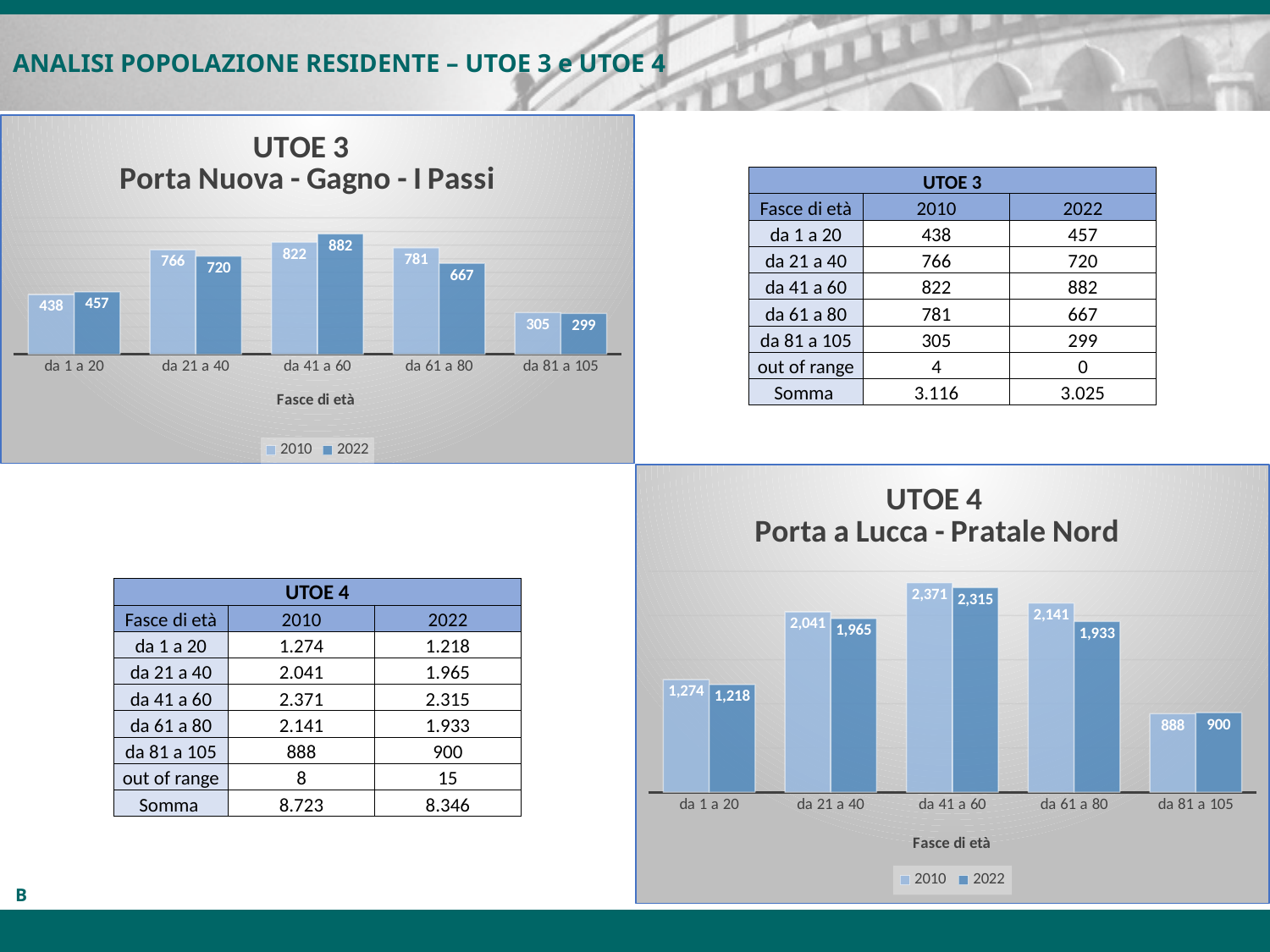
In the UTOE 3 chart, what is the value for 'da 41 a 60' in 2022? 882 In the UTOE 4 chart, what is the difference between the 2010 and 2022 values for 'da 21 a 40'? 76 In the UTOE 3 chart, what is the value for 'da 81 a 105' in 2010? 305 What type of chart is the UTOE 4 chart? Bar chart In the UTOE 3 chart, how many age groups are shown on the x axis? 5 In the UTOE 3 chart, what is the difference between the 2010 and 2022 values for 'da 61 a 80'? 114 In the UTOE 4 chart, what is the value for 'da 41 a 60' in 2010? 2,371 In the UTOE 3 chart, which age group has the highest 2010 value? da 41 a 60 In the UTOE 3 chart, which age group has the lowest 2022 value? da 81 a 105 In the UTOE 4 chart, which is larger for 'da 1 a 20': the 2010 value or the 2022 value? 2010 How many series does the legend of the UTOE 4 chart list? 2 In the UTOE 4 chart, what is the value for 'da 81 a 105' in 2022? 900